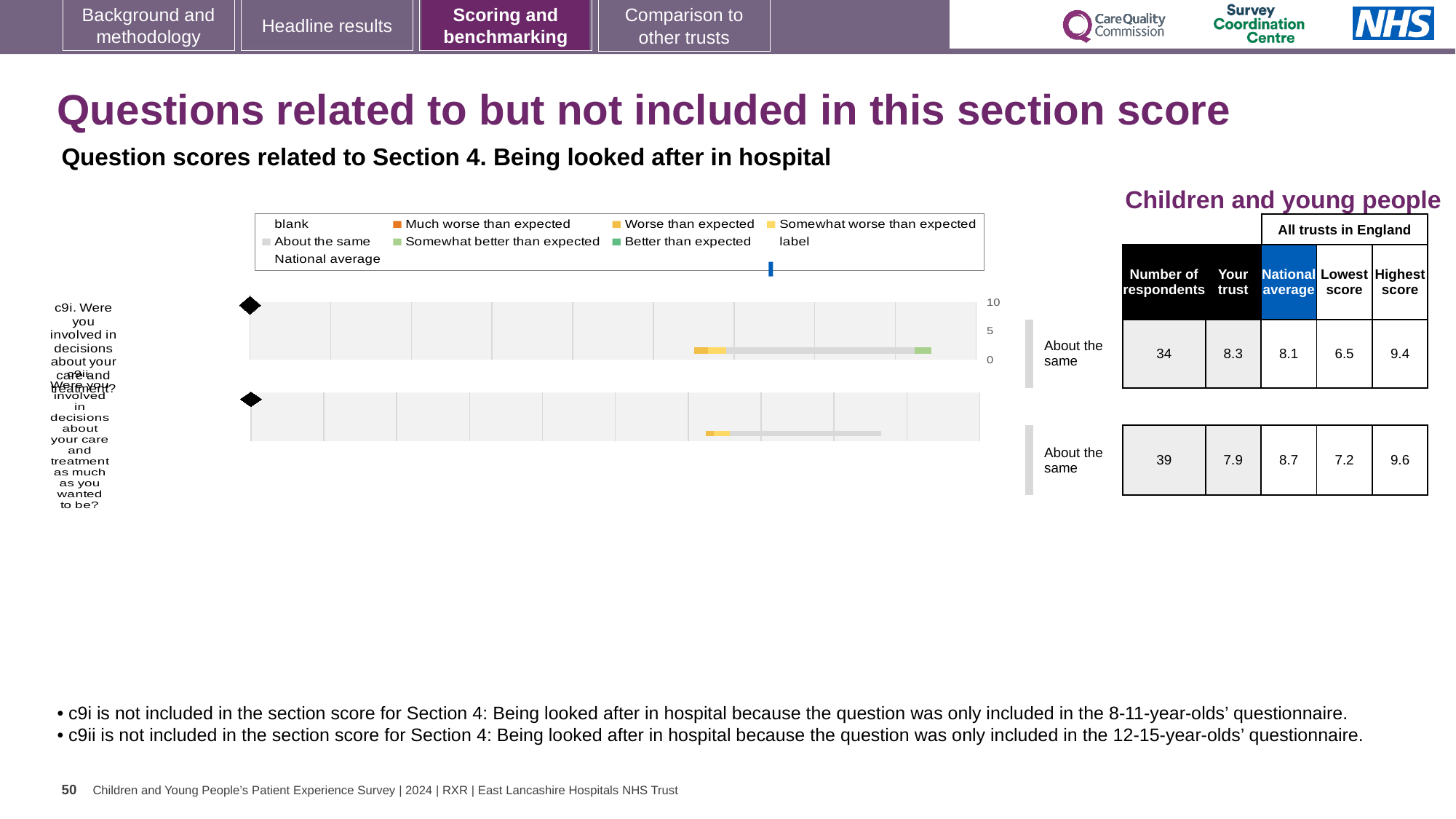
How many questions (bars) are plotted in the chart? 2 Which question has the higher 'Your trust' score in the table beside the chart, c9i or c9ii? c9i In the chart legend, what does the blue marker represent? National average What benchmark category label is shown to the right of the bar for c9ii? About the same Which question has the larger number of respondents in the table beside the chart? c9ii In the table beside the chart, what is the 'Your trust' score for c9ii? 7.9 In the table beside the chart, what is the 'Your trust' score for c9i? 8.3 What kind of chart is used to show the question scores for c9i and c9ii? Bar chart In the table beside the chart, what is the difference between the highest score and the lowest score for c9i? 2.9 In the chart legend, what colour is used for 'Better than expected'? Green In the table beside the chart, what is the national average for c9ii? 8.7 In the table beside the chart, how many respondents answered c9i? 34